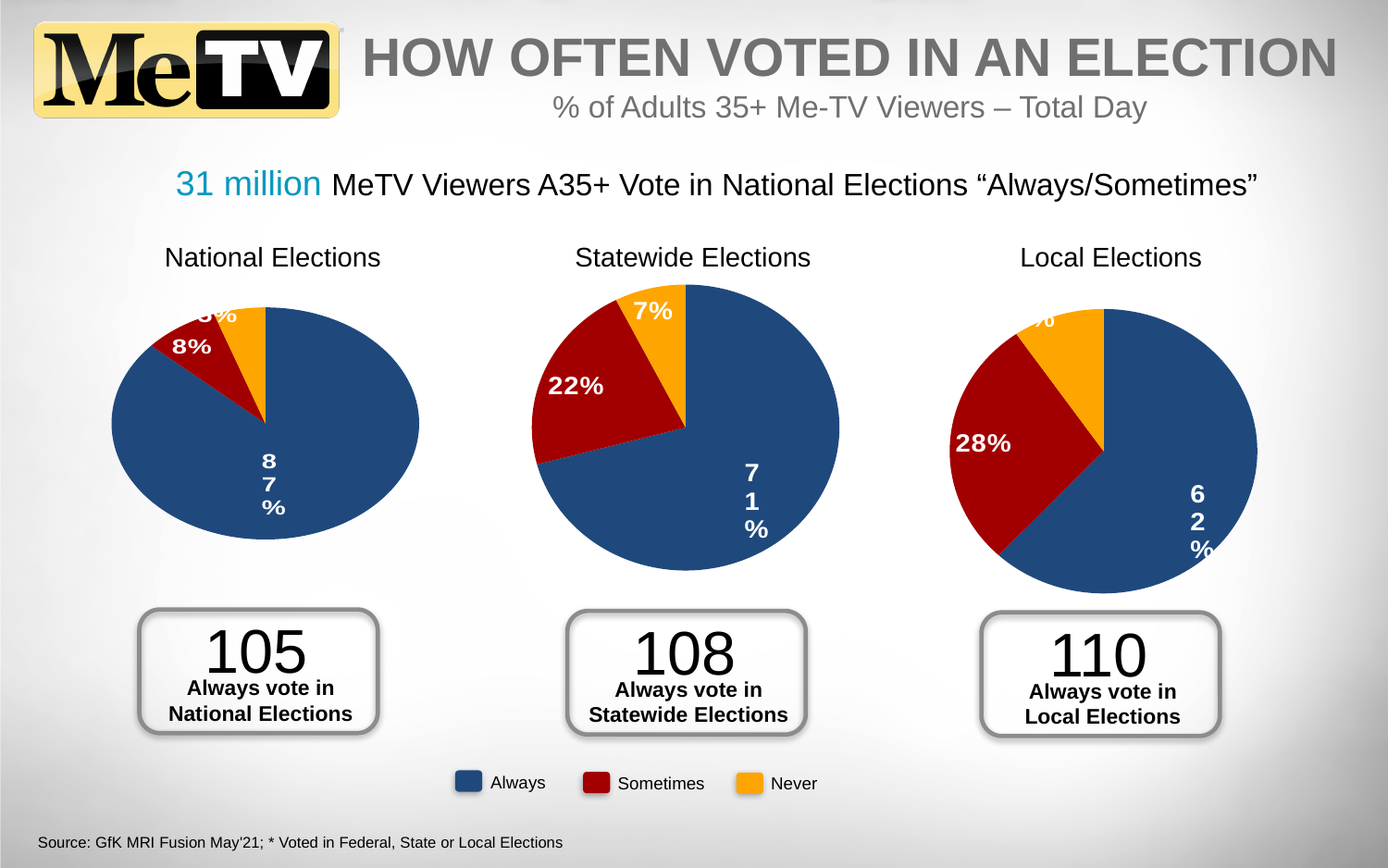
What kind of chart is used for the National Elections, Statewide Elections and Local Elections data? Pie chart In the Statewide Elections pie chart, what percentage of viewers say they Always vote? 71% In the National Elections pie chart, what percentage of viewers say they Always vote? 87% In the Statewide Elections pie chart, what percentage of viewers say they Sometimes vote? 22% In the Local Elections pie chart, what percentage of viewers say they Sometimes vote? 28% In the National Elections pie chart, what percentage of viewers say they Sometimes vote? 8% In the Statewide Elections pie chart, what percentage of viewers say they Never vote? 7% In the Local Elections pie chart, what percentage of viewers say they Always vote? 62% In the Statewide Elections pie chart, what is the difference between the Always share and the Sometimes share? 49% How many categories does the shared legend list for the pie charts? 3 In the Statewide Elections pie chart, which category has the largest slice? Always Which pie chart has the larger Sometimes share, Statewide Elections or Local Elections? Local Elections